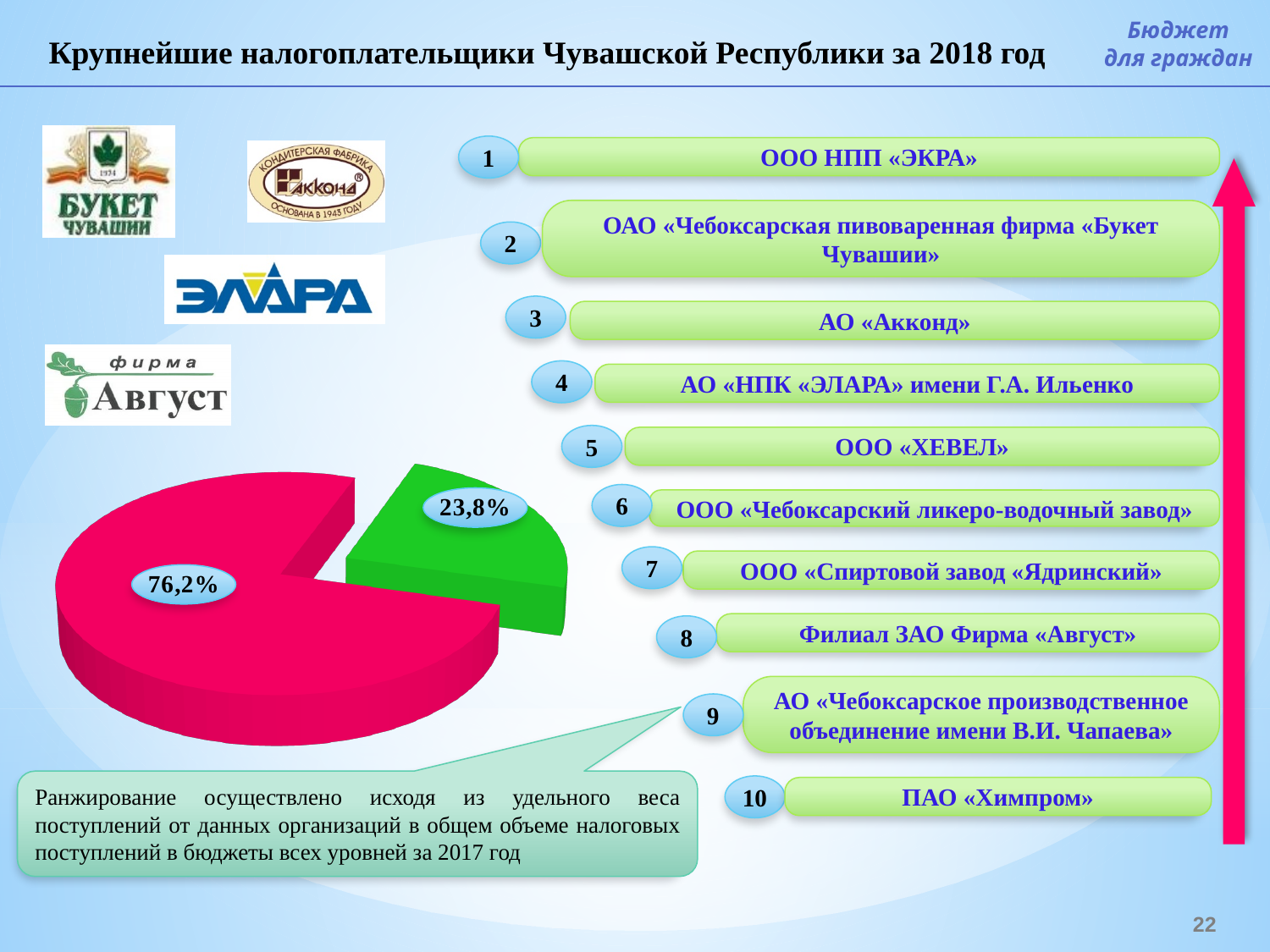
What value is shown on the green slice of the pie chart? 23,8% Which is larger in the pie chart, the pink slice or the green slice? the pink slice What kind of chart is shown on the slide? pie chart What value is shown on the pink slice of the pie chart? 76,2% Which slice of the pie chart is pulled out (exploded) from the rest of the pie? the green slice (23,8%) What share of the pie does the green slice represent? 23,8% Which slice of the pie chart is the largest? the pink slice (76,2%) Which slice of the pie chart is the smallest? the green slice (23,8%) What is the title of the slide containing the pie chart? Крупнейшие налогоплательщики Чувашской Республики за 2018 год What is the total of the two slices shown in the pie chart? 100% How many slices does the pie chart have? 2 What is the difference between the two slices of the pie chart? 52,4%